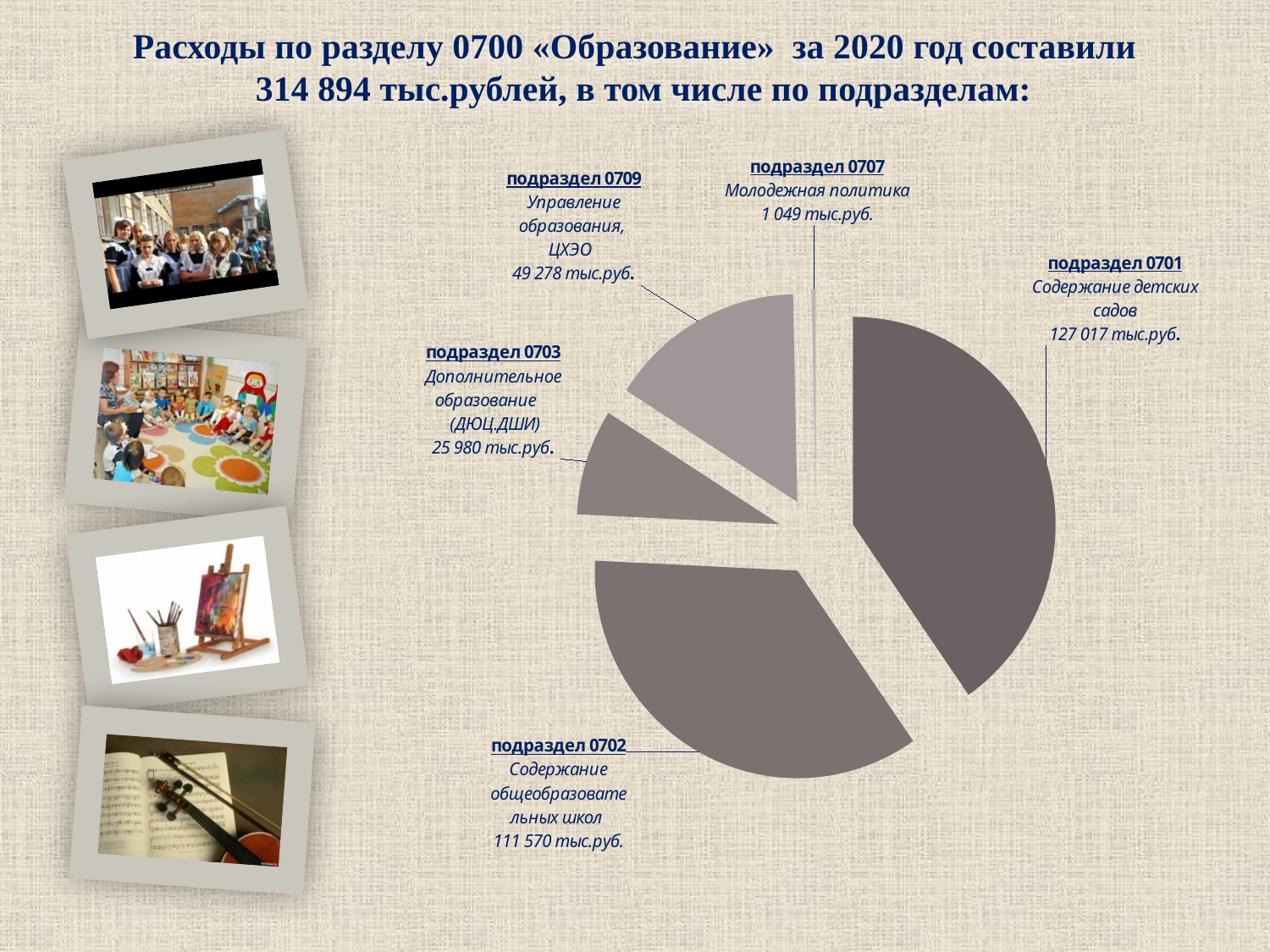
According to the slide title, what were the total expenses for section 0700 «Образование» in 2020? 314 894 тыс.рублей Which subsection has the smallest share of expenses? подраздел 0707 What kind of chart is shown on the slide? pie chart What is the value for подраздел 0709 (Управление образования, ЦХЭО)? 49 278 тыс.руб. What is the difference between the values for подраздел 0701 and подраздел 0702? 15 447 тыс.руб. Which is larger: the value for подраздел 0709 or подраздел 0703? подраздел 0709 How many subsections (slices) does the pie chart show? 5 What is the value for подраздел 0703 (Дополнительное образование)? 25 980 тыс.руб. What is the value for подраздел 0707 (Молодежная политика)? 1 049 тыс.руб. What is the value for подраздел 0702 (Содержание общеобразовательных школ)? 111 570 тыс.руб. Which subsection has the largest share of expenses? подраздел 0701 What is the value for подраздел 0701 (Содержание детских садов)? 127 017 тыс.руб.